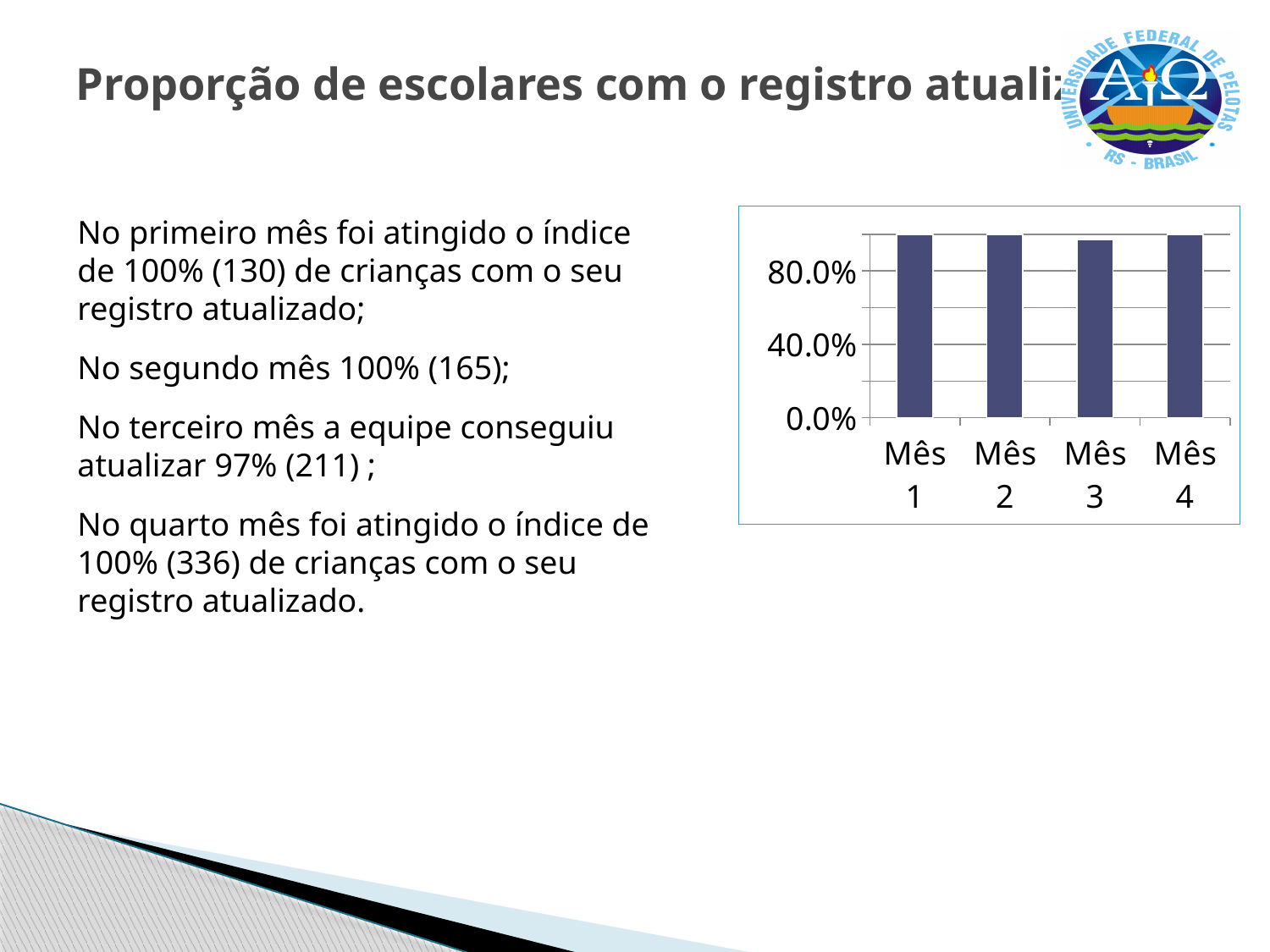
What kind of chart is shown on the slide? bar chart Which is larger, the value for Mês 1 or the value for Mês 3? Mês 1 Is the value for Mês 4 greater or less than 80.0%? greater What are the category labels along the x axis of the chart? Mês 1, Mês 2, Mês 3, Mês 4 How many bars (categories) does the chart show? 4 Which category has the lowest bar in the chart? Mês 3 Is the value for Mês 1 greater or less than 80.0%? greater Is the value for Mês 2 greater or less than 40.0%? greater What is the highest value labelled on the chart's vertical axis? 80.0%